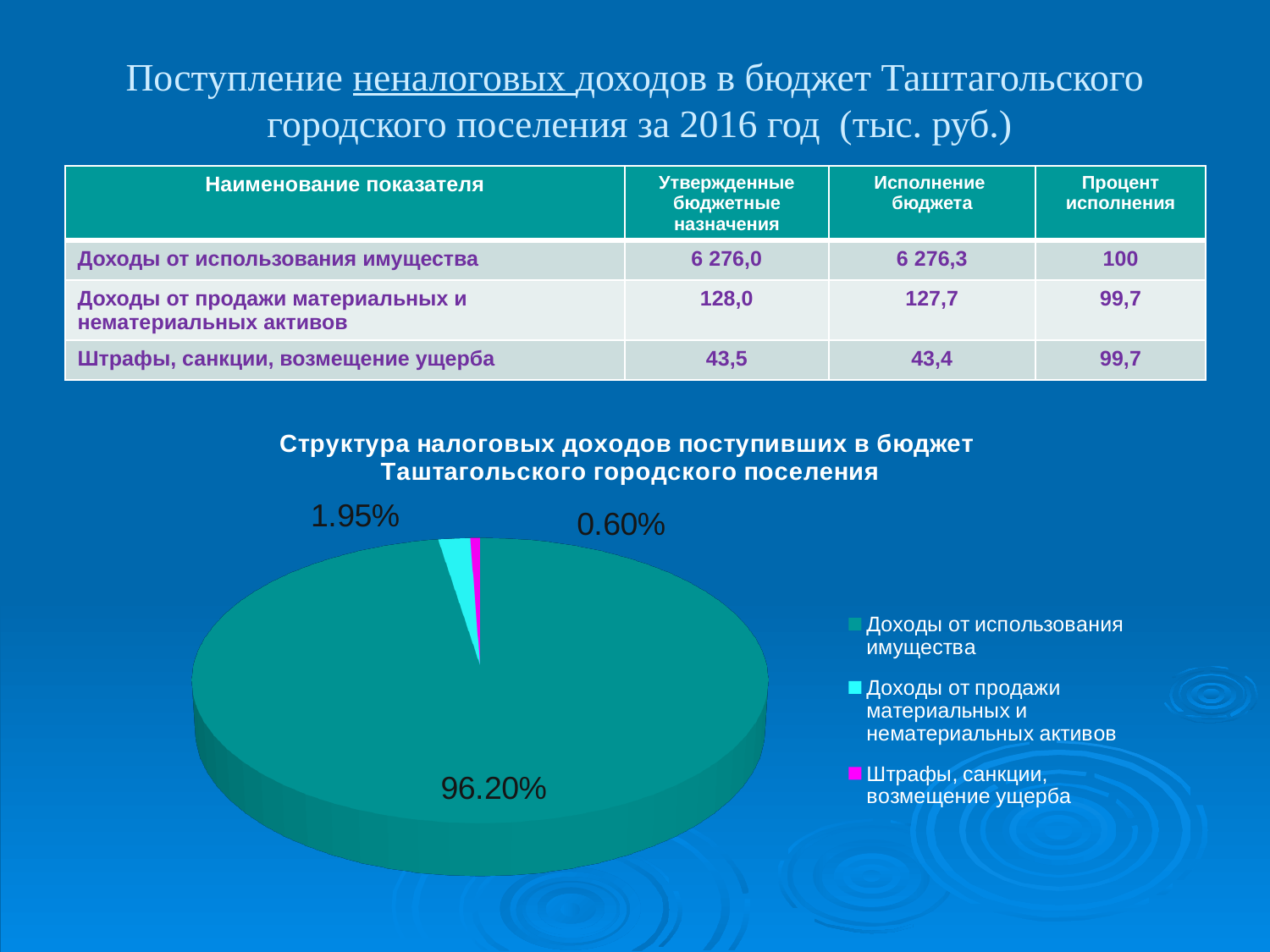
What share of the pie does "Доходы от продажи материальных и нематериальных активов" have? 1.95% What is the difference in percentage points between the slices for "Доходы от продажи материальных и нематериальных активов" and "Штрафы, санкции, возмещение ущерба"? 1.35% What kind of chart is shown on the slide? Pie chart Which category has the smallest slice of the pie? Штрафы, санкции, возмещение ущерба Which slice is larger: "Доходы от продажи материальных и нематериальных активов" or "Штрафы, санкции, возмещение ущерба"? Доходы от продажи материальных и нематериальных активов What share of the pie does "Доходы от использования имущества" have? 96.20% Which category has the largest slice of the pie? Доходы от использования имущества How many entries does the legend of the pie chart list? 3 What colour is the slice for "Штрафы, санкции, возмещение ущерба" in the pie chart? Magenta How many slices does the pie chart have? 3 What is the title of the pie chart? Структура налоговых доходов поступивших в бюджет Таштагольского городского поселения What share of the pie does "Штрафы, санкции, возмещение ущерба" have? 0.60%